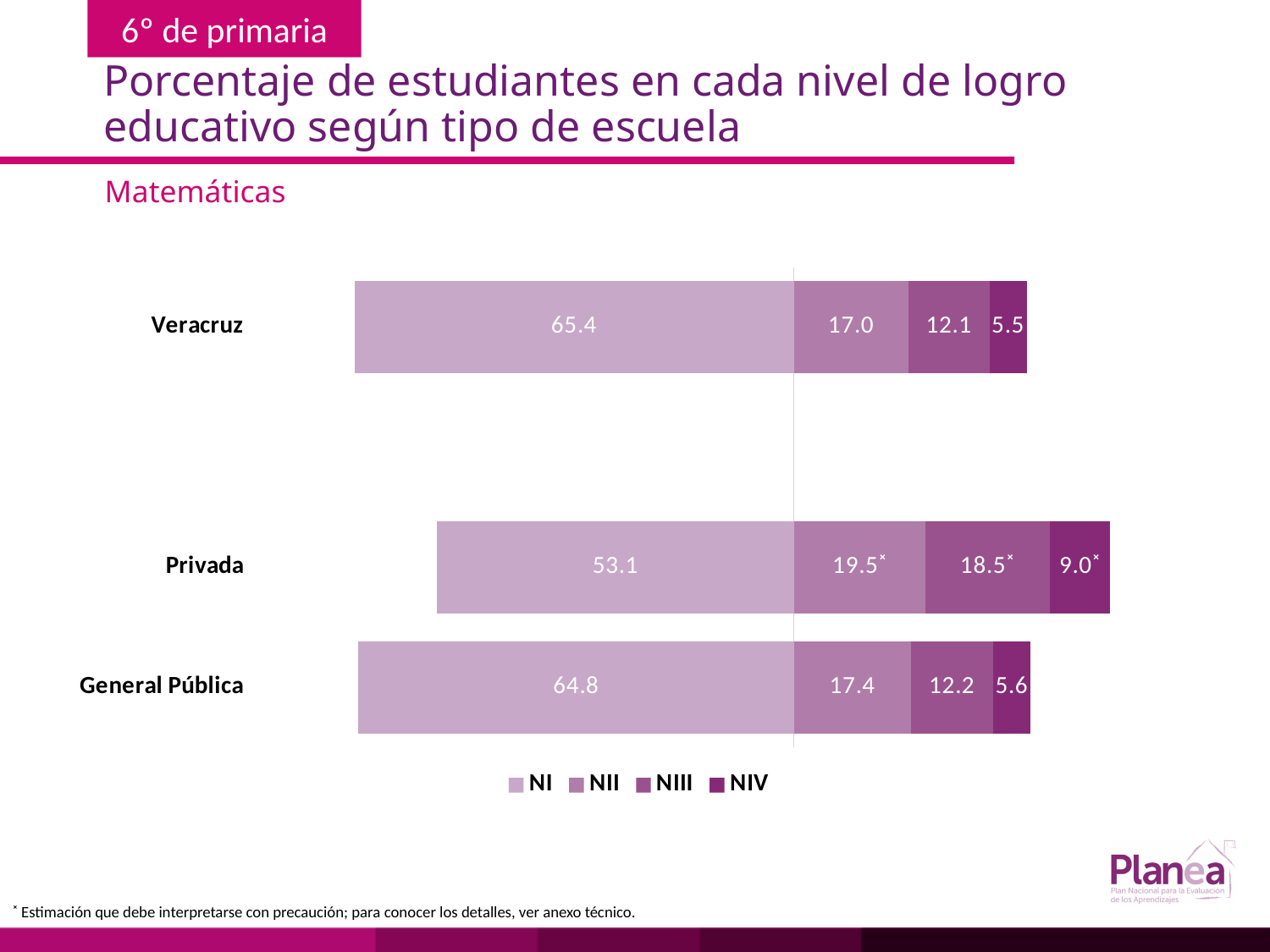
Which school type has the lowest NI value? Privada How many school types (categories) are shown in the chart? 3 What is the NIV value for Privada? 9.0 Which is larger, the NIII value for Privada or the NIII value for General Pública? Privada What is the NI value for Veracruz? 65.4 What is the NII value for General Pública? 17.4 Which school type has the highest NI value? Veracruz What is the difference between the NI values for Veracruz and Privada? 12.3 How many series does the legend list? 4 What is the total of the stacked bar for Veracruz? 100.0 What is the NIII value for Veracruz? 12.1 What kind of chart is shown on the slide? Stacked bar chart